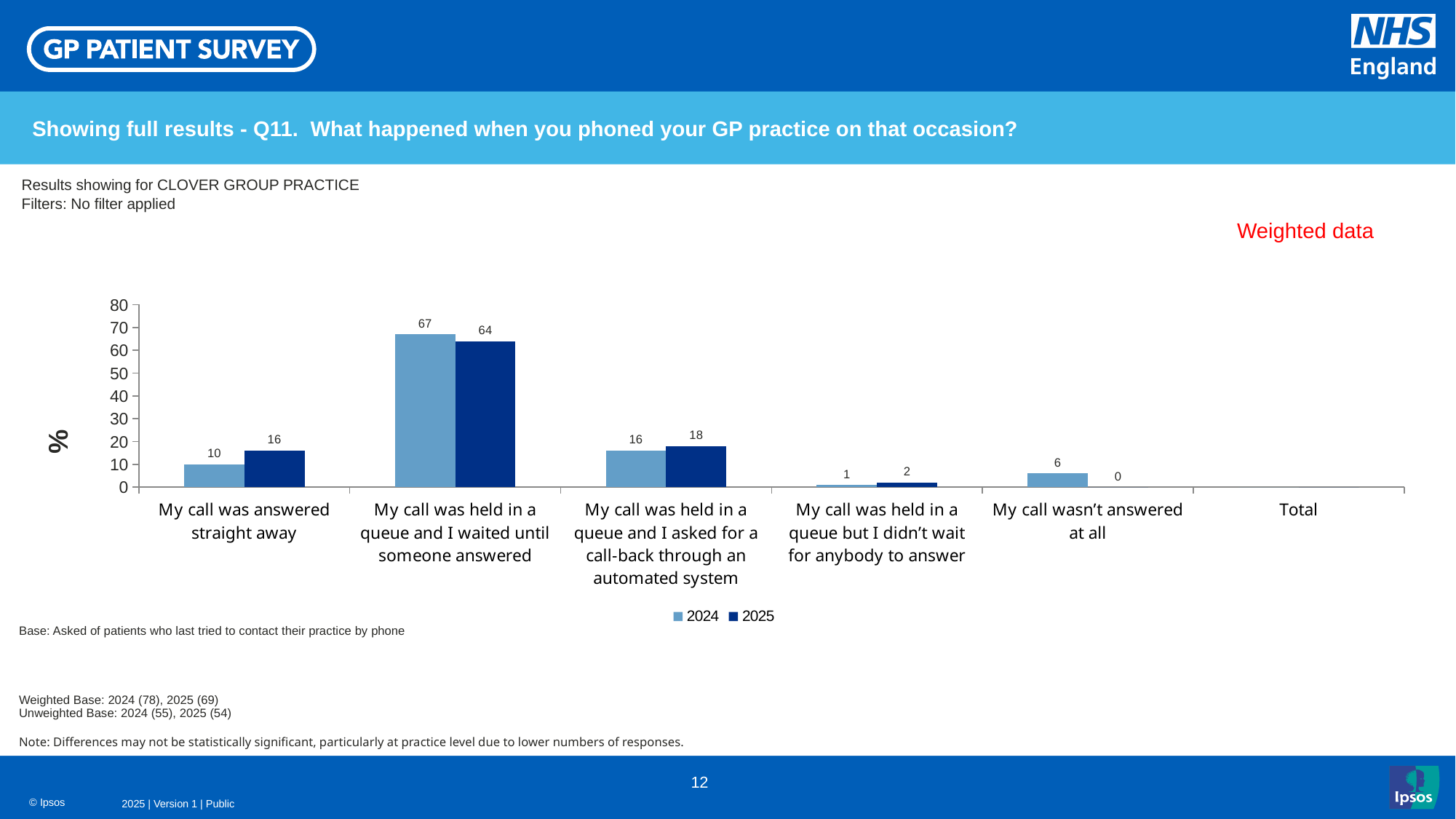
What is the 2024 value for 'My call was answered straight away'? 10 Which category has the lowest 2025 value? My call wasn't answered at all What is the 2025 value for 'My call was held in a queue and I waited until someone answered'? 64 What is the label on the vertical axis of the chart? % What is the 2025 value for 'My call wasn't answered at all'? 0 For 'My call was held in a queue and I asked for a call-back through an automated system', which year has the larger value, 2024 or 2025? 2025 What is the difference between the 2024 and 2025 values for 'My call was answered straight away'? 6 Which category has the highest 2024 value? My call was held in a queue and I waited until someone answered Is the 2024 value for 'My call was held in a queue and I waited until someone answered' greater or less than 60? greater How many series does the legend list? 2 Which series is shown in the darker blue colour? 2025 What kind of chart is shown on the slide? Bar chart